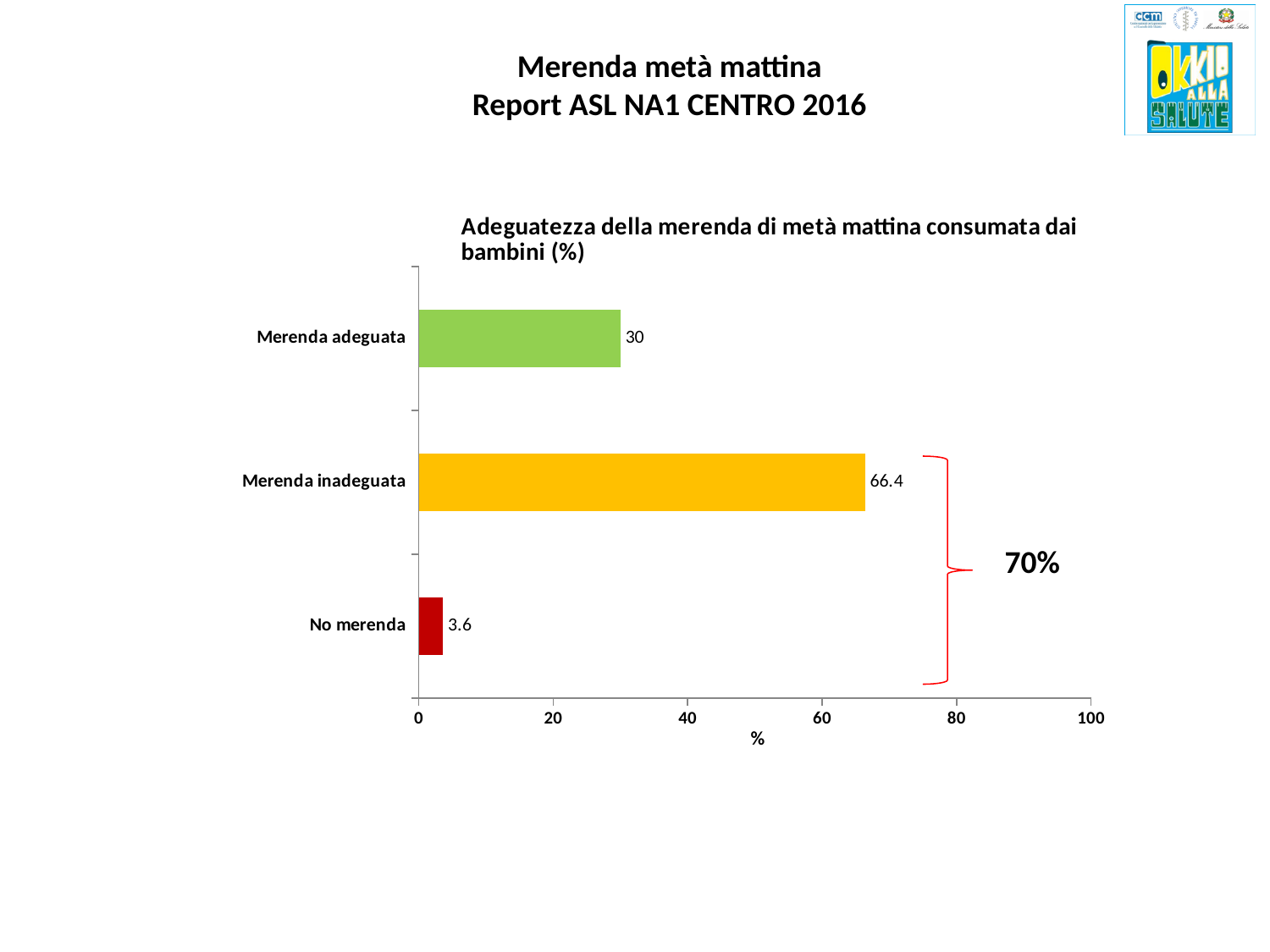
Which is larger, the value for Merenda adeguata or the value for No merenda? Merenda adeguata What percentage is shown next to the red bracket grouping Merenda inadeguata and No merenda? 70% How many categories are shown in the chart? 3 What is the value for Merenda inadeguata? 66.4 What is the value for No merenda? 3.6 Which category has the lowest value? No merenda What kind of chart is shown on the slide? Bar chart Which category has the highest value? Merenda inadeguata What is the difference between the values for Merenda adeguata and No merenda? 26.4 What is the value for Merenda adeguata? 30 What is the difference between the values for Merenda inadeguata and Merenda adeguata? 36.4 Is the value for Merenda inadeguata greater or less than 60? greater